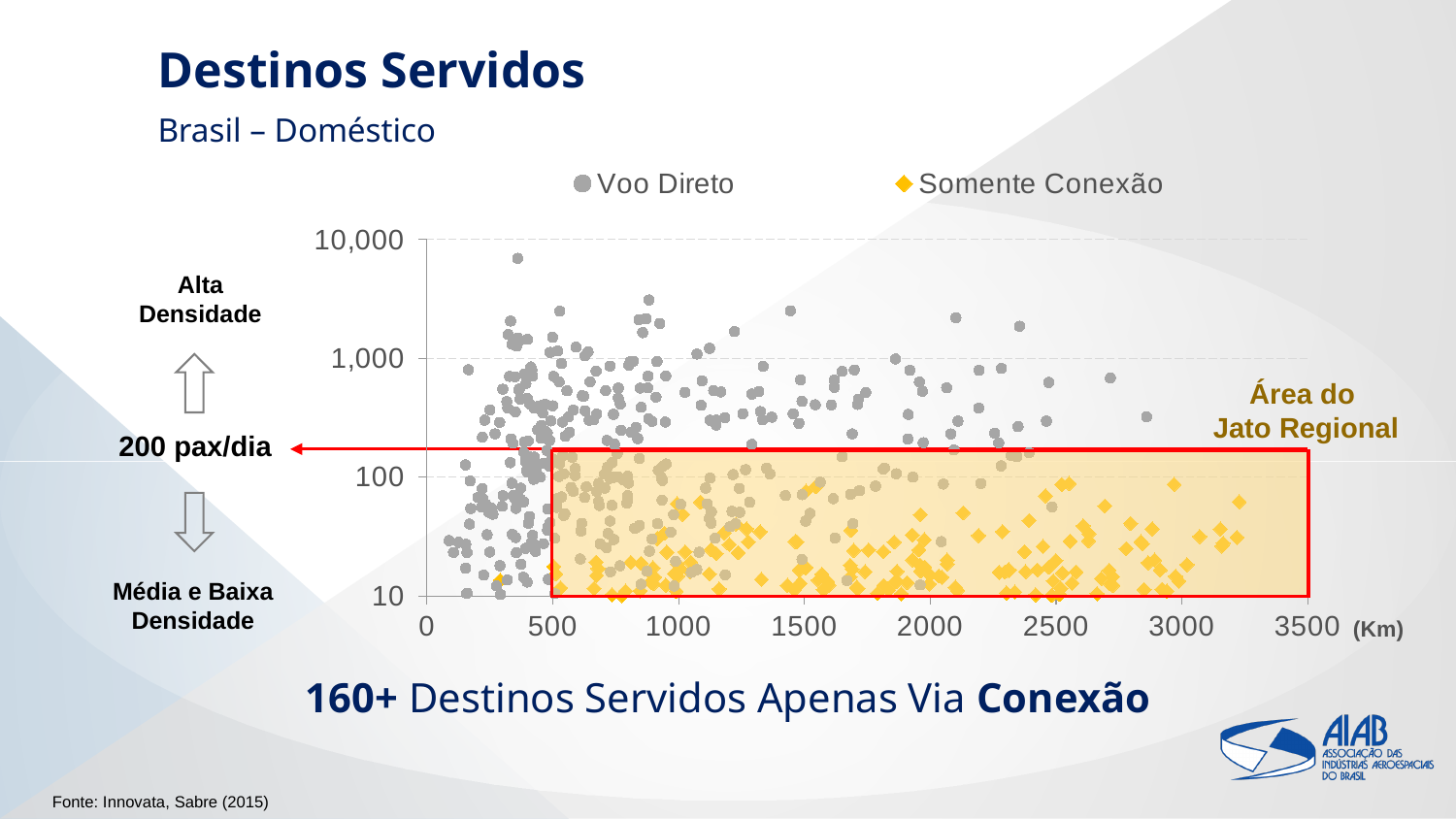
Is the lowest Voo Direto point greater or less than 100 on the vertical axis? less How many series does the chart legend list? 2 What unit is shown for the horizontal axis of the chart? Km Is the highest Voo Direto point greater or less than 1,000 on the vertical axis? greater What kind of chart is shown on the slide? Scatter chart What is the highest tick value shown on the horizontal axis? 3500 Are the Somente Conexão points greater or less than 200 pax/dia on the vertical axis? less What are the two series named in the chart legend? Voo Direto and Somente Conexão What value is marked by the red horizontal line on the chart? 200 pax/dia What is the highest tick value shown on the vertical axis? 10,000 Which series is plotted with yellow diamond markers? Somente Conexão Which series contains the point with the highest value on the vertical axis? Voo Direto